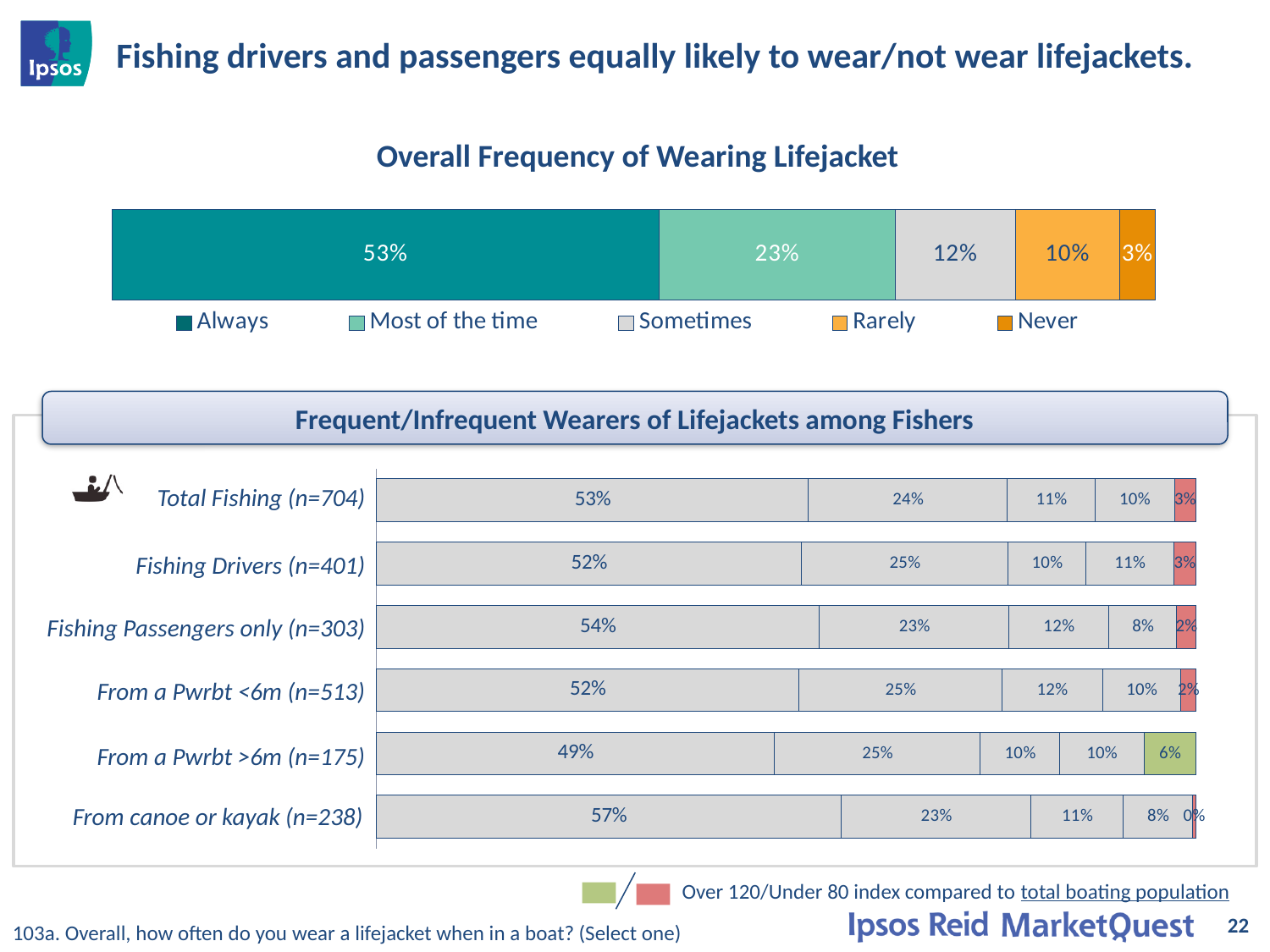
In the 'Frequent/Infrequent Wearers of Lifejackets among Fishers' chart, what is the Never percentage for From canoe or kayak (n=238)? 0% How many series does the legend of the 'Overall Frequency of Wearing Lifejacket' chart list? 5 In the 'Overall Frequency of Wearing Lifejacket' chart, what is the difference between the Always and Most of the time percentages? 30 percentage points In the 'Frequent/Infrequent Wearers of Lifejackets among Fishers' chart, which has a higher Always percentage: Fishing Drivers (n=401) or Fishing Passengers only (n=303)? Fishing Passengers only (n=303) In the 'Frequent/Infrequent Wearers of Lifejackets among Fishers' chart, what is the first (Always) percentage for Fishing Drivers (n=401)? 52% In the 'Overall Frequency of Wearing Lifejacket' chart, what percentage say they Never wear a lifejacket? 3% In the 'Frequent/Infrequent Wearers of Lifejackets among Fishers' chart, which category has the lowest Always percentage? From a Pwrbt >6m (n=175) How many categories are shown in the 'Frequent/Infrequent Wearers of Lifejackets among Fishers' chart? 6 In the 'Frequent/Infrequent Wearers of Lifejackets among Fishers' chart, what is the Never percentage for From a Pwrbt >6m (n=175)? 6% What kind of chart is the 'Overall Frequency of Wearing Lifejacket' chart? Stacked bar chart In the 'Frequent/Infrequent Wearers of Lifejackets among Fishers' chart, which category has the highest Always percentage? From canoe or kayak (n=238) In the 'Overall Frequency of Wearing Lifejacket' chart, what percentage of respondents say they Always wear a lifejacket? 53%